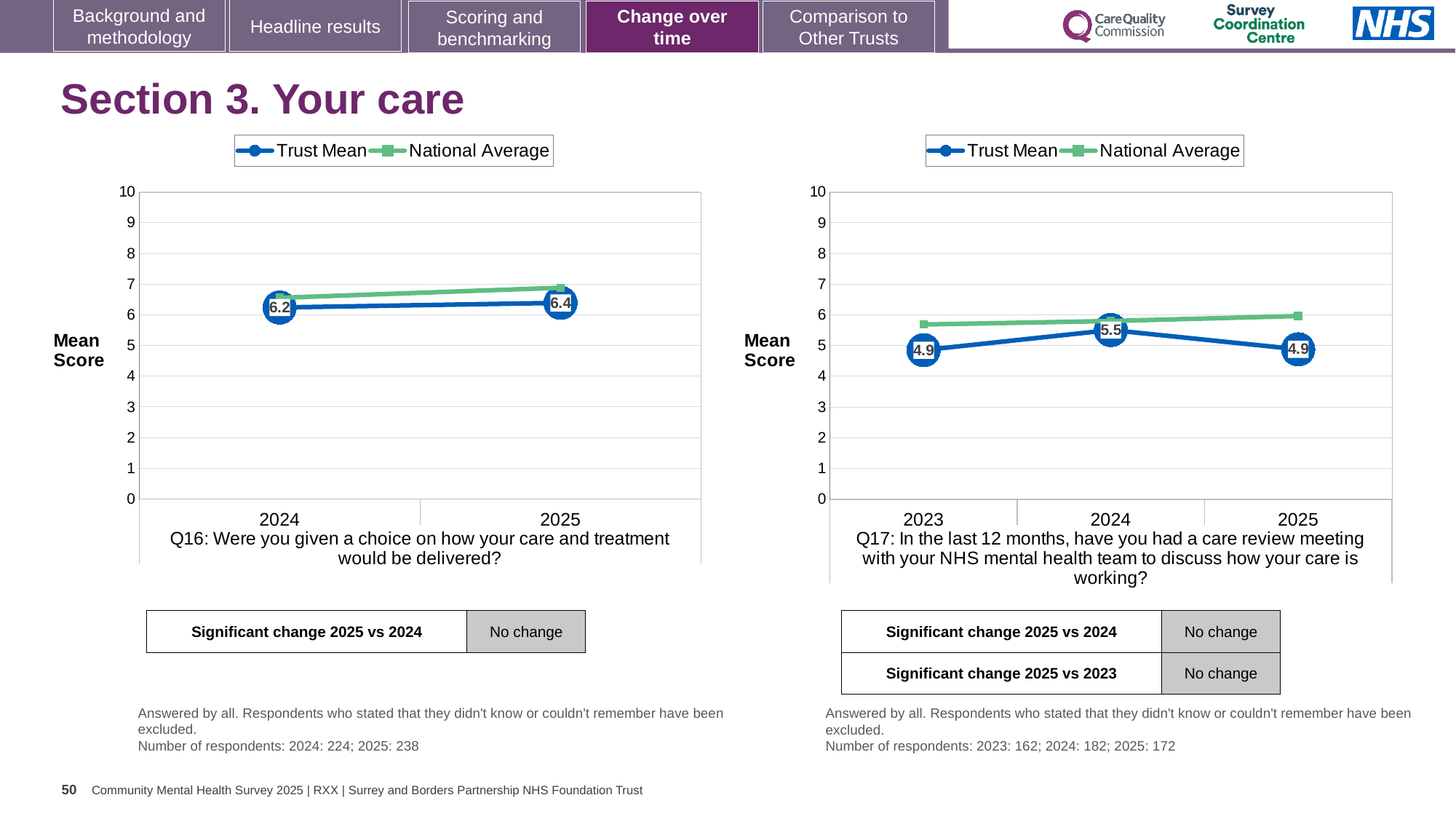
In the Q17 chart on the right, is the National Average for 2025 greater or less than 5? greater In the Q17 chart on the right, what is the difference between the Trust Mean for 2024 and the Trust Mean for 2025? 0.6 In the Q17 chart on the right, what is the Trust Mean for 2024? 5.5 In the Q17 chart on the right, which is larger in 2023, the Trust Mean or the National Average? National Average In the Q16 chart on the left, what is the Trust Mean for 2025? 6.4 In the Q16 chart on the left, is the National Average for 2025 greater or less than 6? greater In the Q17 chart on the right, which year has the highest Trust Mean? 2024 How many years are plotted on the x axis of the Q17 chart on the right? 3 What type of chart is the Q16 chart on the left? Line chart In the Q16 chart on the left, what is the Trust Mean for 2024? 6.2 In the Q17 chart on the right, what is the Trust Mean for 2023? 4.9 In the Q16 chart on the left, by how much did the Trust Mean change from 2024 to 2025? 0.2